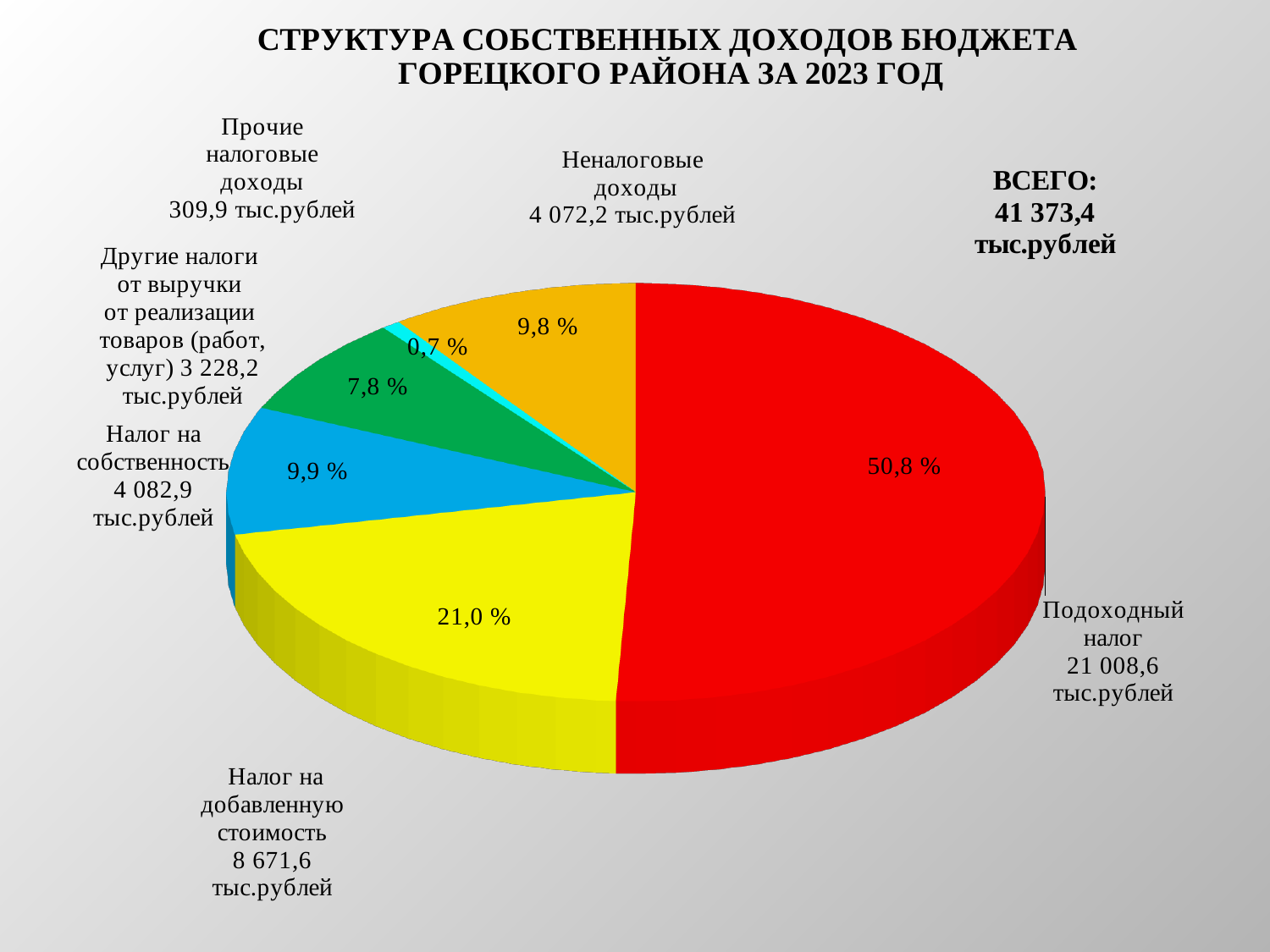
Which category has the smallest slice of the pie? Прочие налоговые доходы Which is larger: Налог на собственность or Неналоговые доходы? Налог на собственность What is the difference between Подоходный налог and Налог на добавленную стоимость in тыс.рублей? 12 337,0 тыс.рублей What is the value for Подоходный налог? 21 008,6 тыс.рублей Which category has the largest slice of the pie? Подоходный налог How many slices does the pie chart have? 6 What is the value for Налог на добавленную стоимость? 8 671,6 тыс.рублей What total (ВСЕГО) is shown on the slide? 41 373,4 тыс.рублей What is the value for Неналоговые доходы? 4 072,2 тыс.рублей What kind of chart is shown on the slide? Pie chart What share of the pie does Прочие налоговые доходы represent? 0,7 % What share of the pie does Налог на собственность represent? 9,9 %